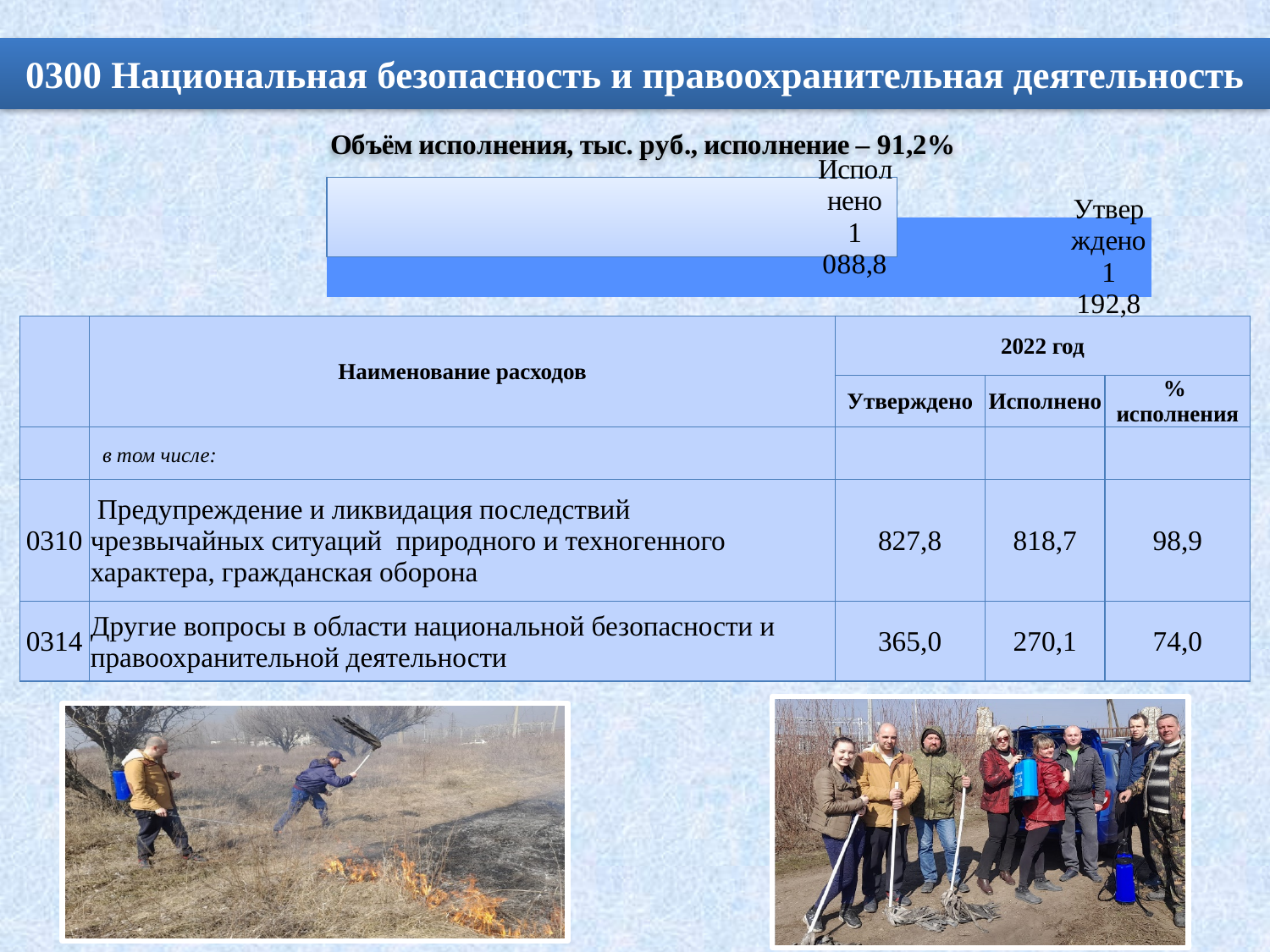
How many bars are plotted in the chart? 2 What type of chart is shown on the slide? bar chart Which bar in the chart has the higher value, Утверждено or Исполнено? Утверждено What is the difference between the Утверждено and Исполнено values in the chart? 104,0 What execution percentage is stated in the chart title? 91,2% Is the Исполнено value larger or smaller than the Утверждено value in the chart? smaller What is the value of the Исполнено bar in the chart? 1 088,8 What is the title of the chart on the slide? Объём исполнения, тыс. руб., исполнение – 91,2% Which bar in the chart has the lower value? Исполнено What is the value of the Утверждено bar in the chart? 1 192,8